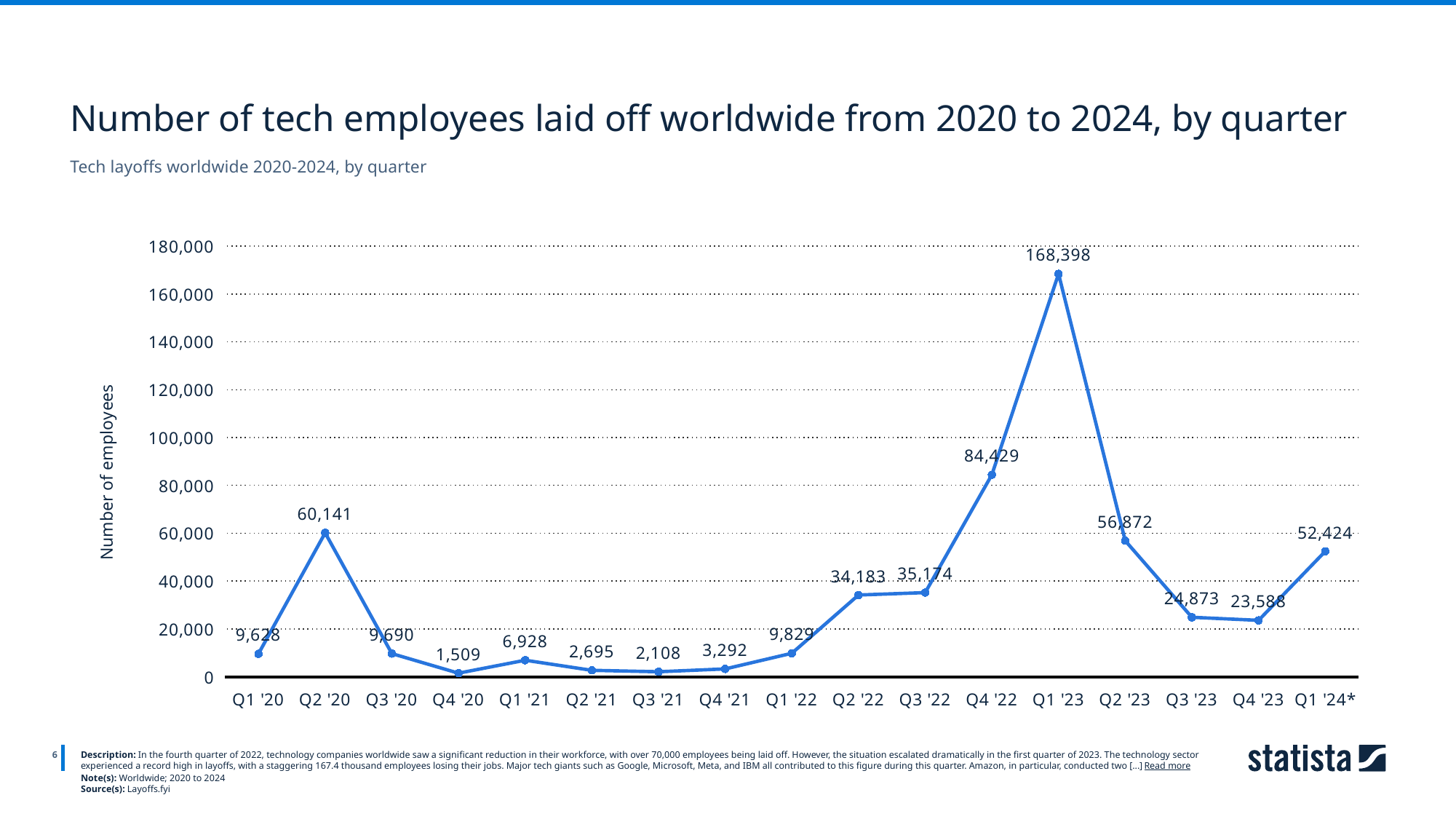
What is the number of employees laid off in Q1 '24*? 52,424 How many tech employees were laid off worldwide in Q1 '23? 168,398 What kind of chart is shown on the slide? line chart What is the label of the y axis? Number of employees What is the difference between the values for Q3 '23 and Q4 '23? 1,285 What is the difference between the values for Q1 '23 and Q4 '22? 83,969 Which quarter has the highest number of tech layoffs? Q1 '23 Is the value for Q4 '22 greater or less than 80,000? greater Which quarter has the lowest number of tech layoffs? Q4 '20 How many quarters are plotted on the chart? 17 What is the value shown for Q4 '20? 1,509 Which quarter has a larger value, Q4 '22 or Q2 '23? Q4 '22